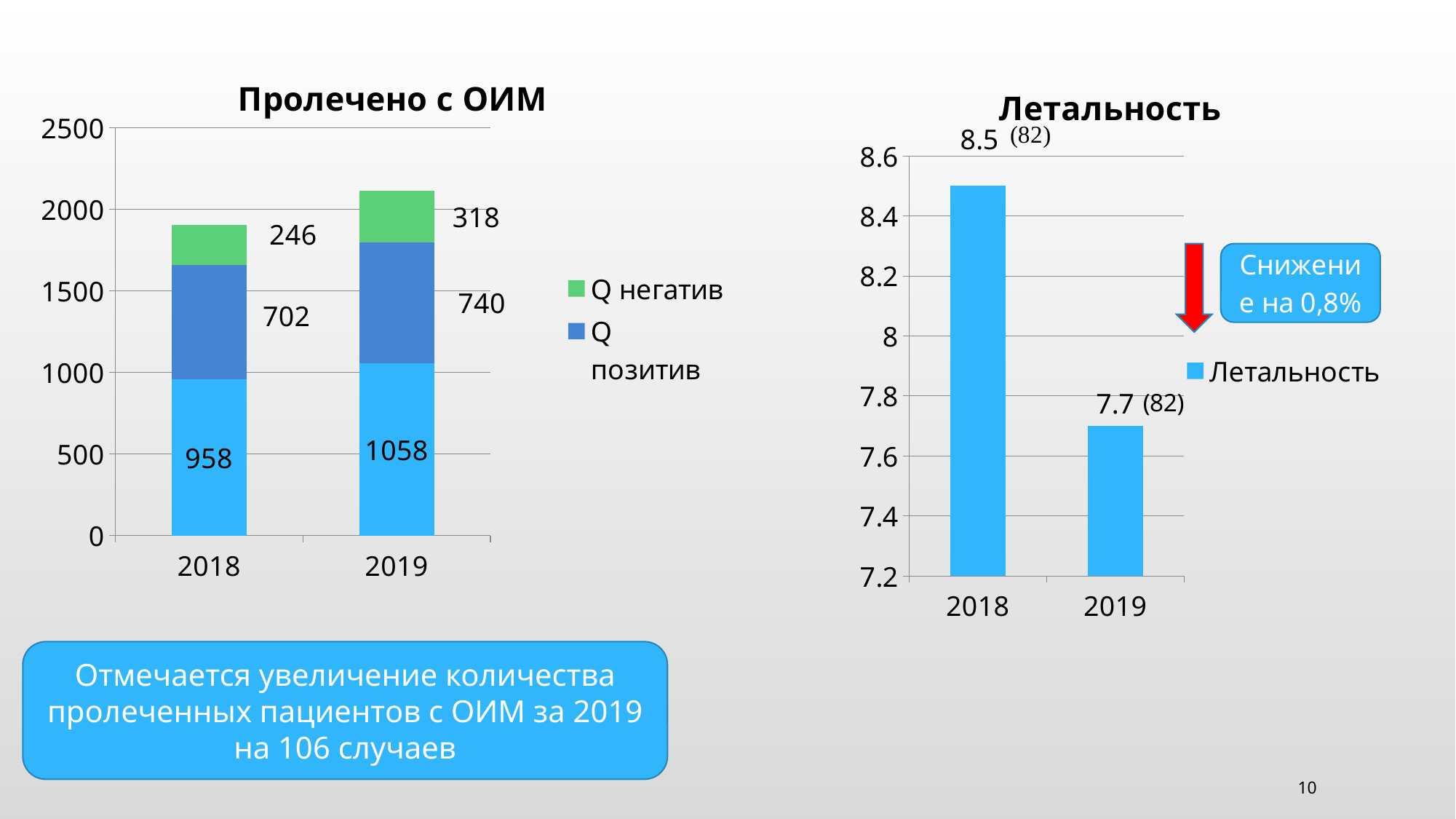
In the 'Пролечено с ОИМ' chart, what is the value of the bottom light-blue segment for 2019? 1058 What kind of chart is the 'Пролечено с ОИМ' chart on the left? stacked bar chart In the 'Пролечено с ОИМ' chart, which year has the larger Q позитив value, 2018 or 2019? 2019 In the 'Летальность' chart, do the values rise or fall from 2018 to 2019? fall In the 'Пролечено с ОИМ' chart, by how much did Q негатив increase from 2018 to 2019? 72 In the 'Летальность' chart, what is the value for 2019? 7.7 In the 'Пролечено с ОИМ' chart, what is the value of Q позитив for 2018? 702 How many series does the legend of the 'Пролечено с ОИМ' chart list? 2 In the 'Летальность' chart, what is the value for 2018? 8.5 In the 'Пролечено с ОИМ' chart, what is the total of the stacked bar for 2019? 2116 In the 'Пролечено с ОИМ' chart, what is the value of Q негатив for 2019? 318 In the 'Летальность' chart, what is the difference between the 2018 and 2019 values? 0.8